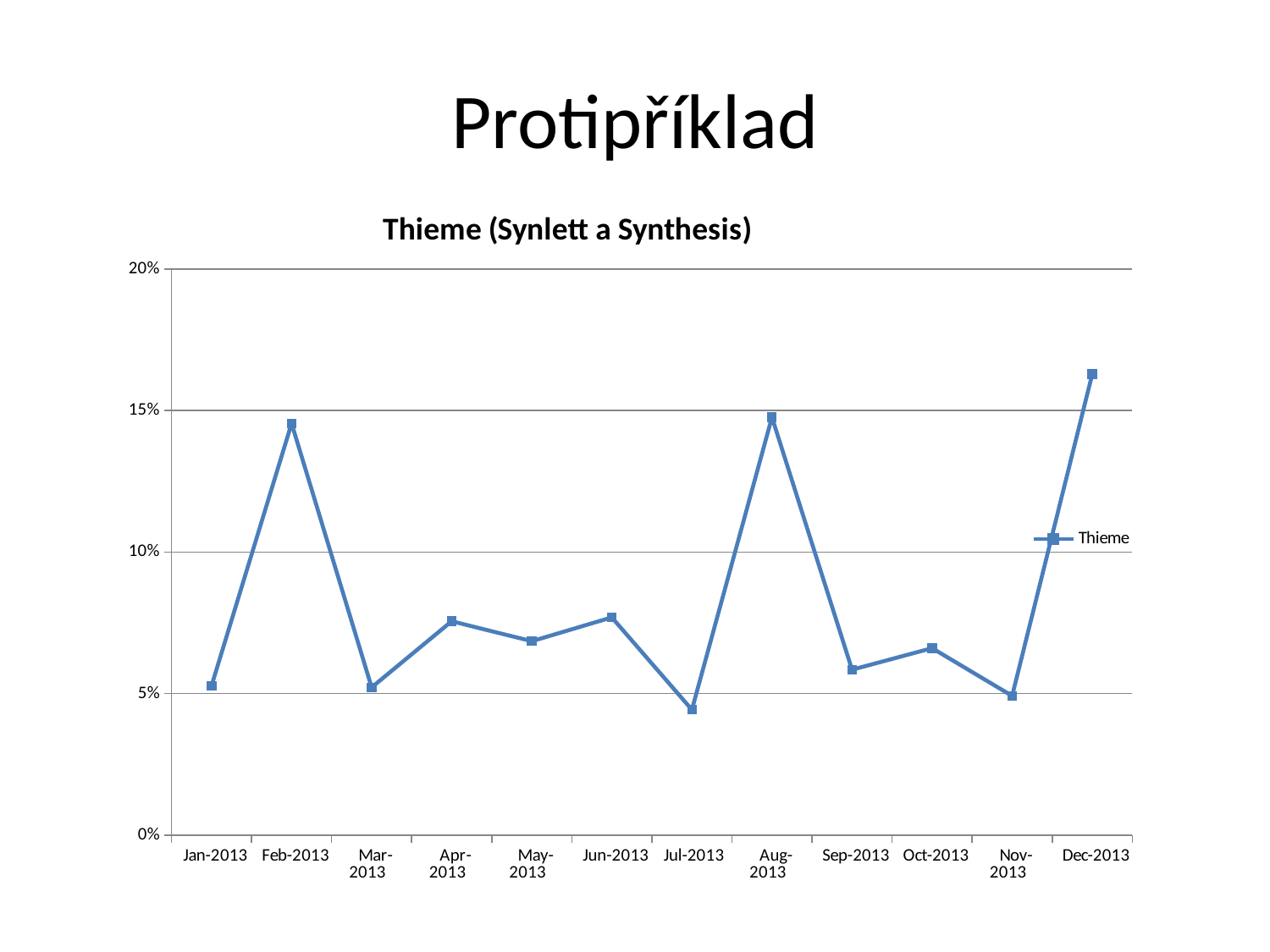
Do the values rise or fall from Aug-2013 to Nov-2013? fall Which is larger, the value for Feb-2013 or the value for Dec-2013? Dec-2013 How many months are plotted on the x axis? 12 Is the value for Dec-2013 greater or less than 15%? greater Is the value for Jul-2013 greater or less than 5%? less What kind of chart is shown on the slide? line chart Which month has the highest value? Dec-2013 What is the title of the chart? Thieme (Synlett a Synthesis) Is the value for Feb-2013 greater or less than 10%? greater How many series does the legend list? 1 Which month has the lowest value? Jul-2013 Which is larger, the value for Apr-2013 or the value for Jul-2013? Apr-2013